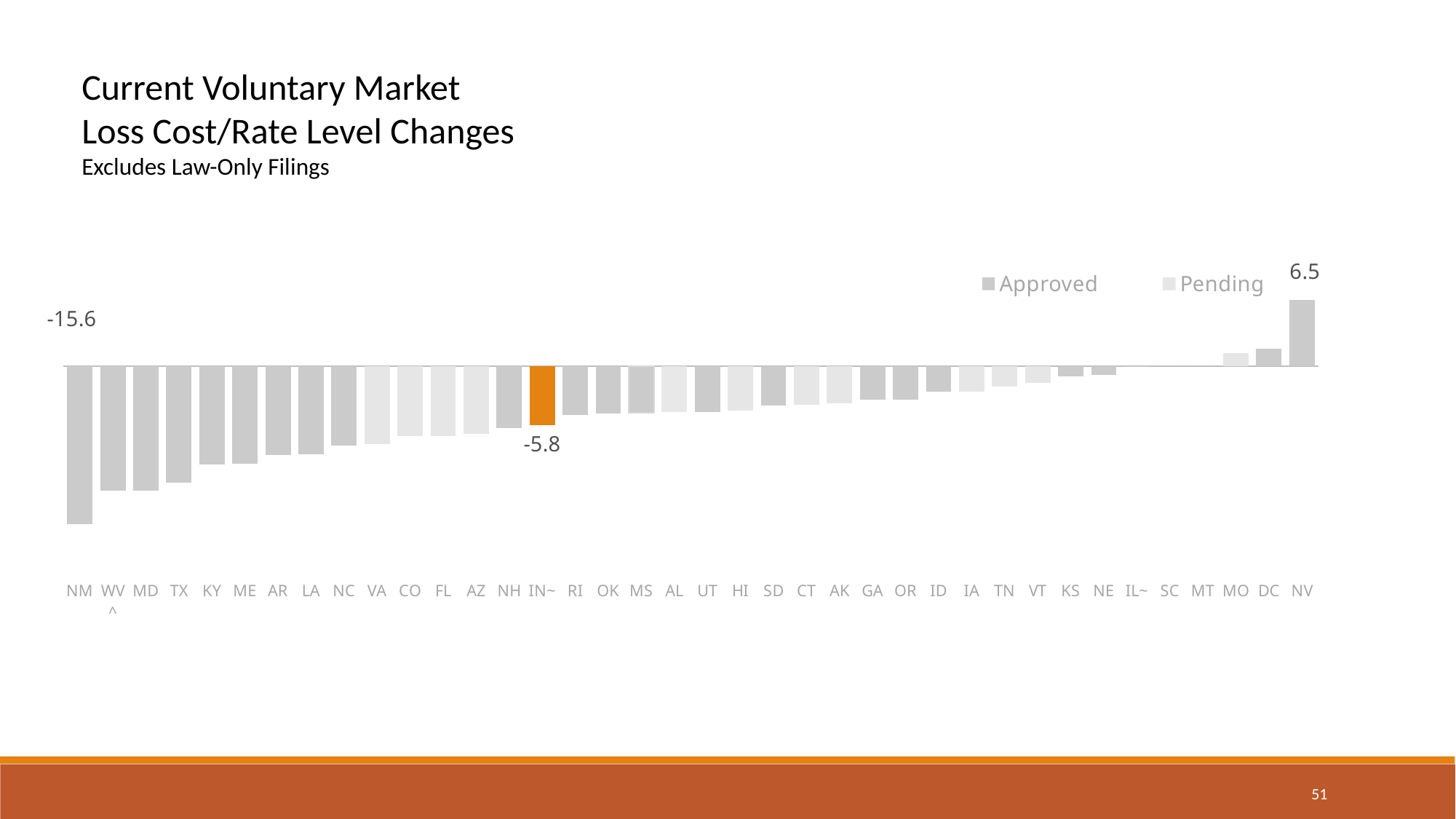
What is the difference between the values for NV and NM? 22.1 How many states are shown on the x axis? 38 Do the values rise or fall from left to right along the x axis? Rise Which state has the lowest value? NM What kind of chart is shown on the slide? Bar chart What is the value for IN~? -5.8 Which state has the highest value? NV What is the value for NV? 6.5 What is the value for NM? -15.6 What is the difference between the values for IN~ and NM? 9.8 How many series does the legend list? 2 Which is larger, the value for IN~ or the value for NM? IN~